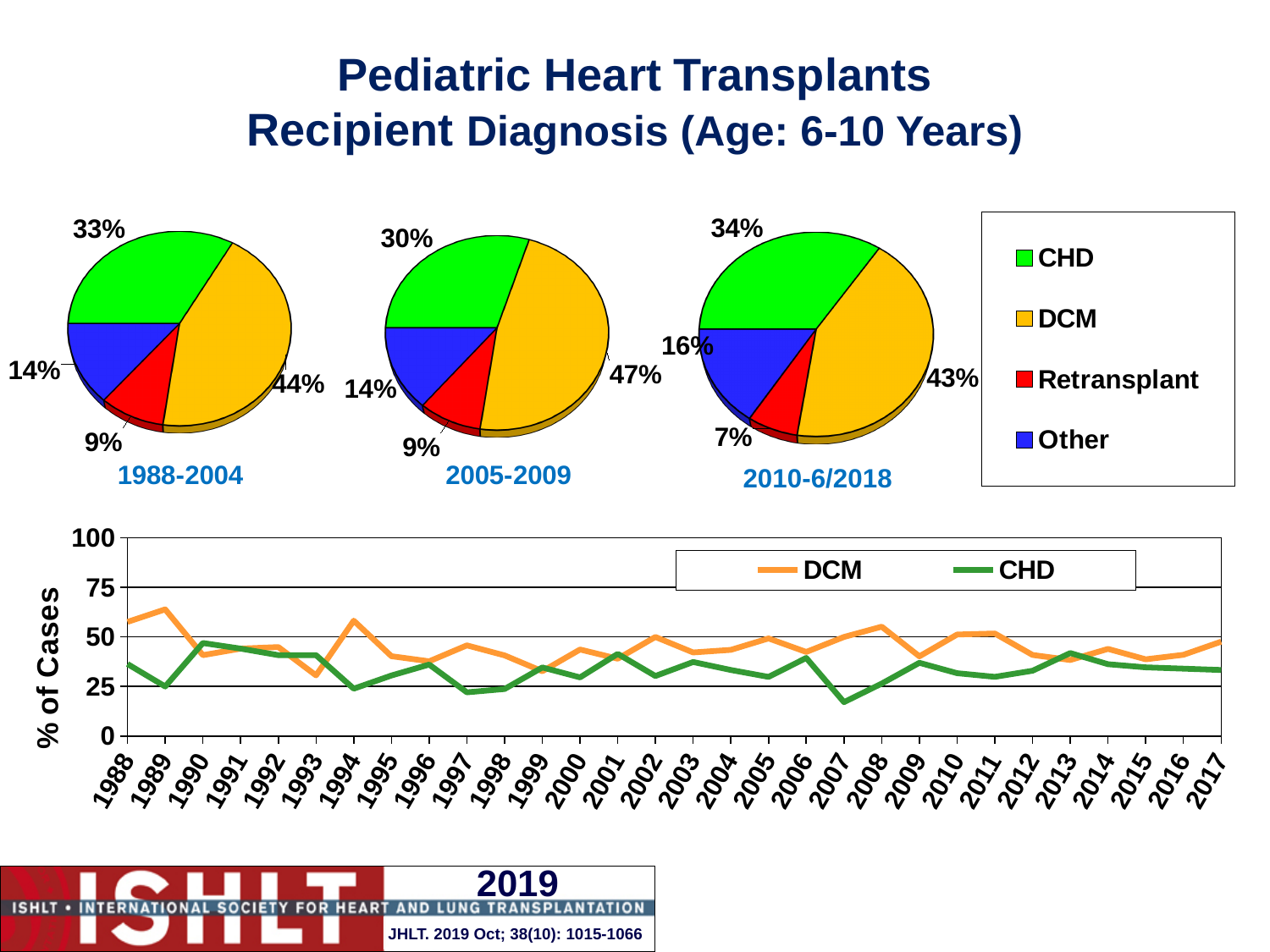
In the 2005-2009 pie chart, what is the difference between the DCM share and the CHD share? 17% In the line chart, is the DCM value for 1989 greater or less than 50? greater In the 2010-6/2018 pie chart, what share of cases is Retransplant? 7% In the 2010-6/2018 pie chart, which diagnosis has the largest share? DCM In the 1988-2004 pie chart, what share of cases is DCM? 44% How many series does the legend of the line chart list? 2 In the 2010-6/2018 pie chart, which is larger, the Other share or the Retransplant share? Other In the 2005-2009 pie chart, what share of cases is CHD? 30% In the 1988-2004 pie chart, which diagnosis has the smallest share? Retransplant How many pie charts are shown on the slide? 3 In the line chart, is the CHD value for 2007 greater or less than 25? less What kind of chart is the bottom chart on the slide? Line chart